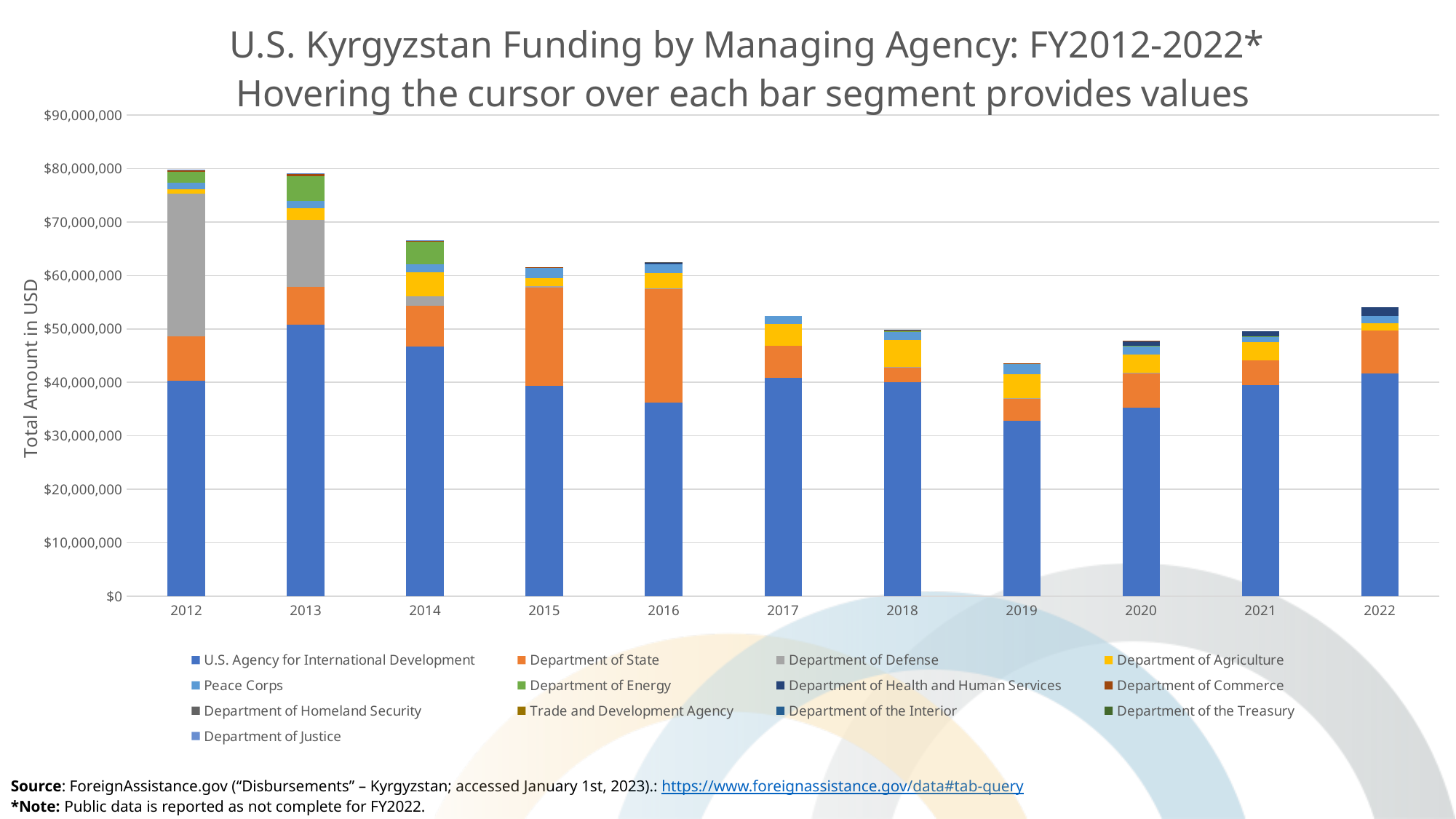
Is the total funding for 2012 greater or less than $70,000,000? greater How many managing agencies does the legend list? 13 What is the label on the y axis? Total Amount in USD Is the total funding for 2019 greater or less than $50,000,000? less Do total funding amounts generally rise or fall from 2012 to 2019? fall How many fiscal years are shown along the x axis? 11 Which year has the larger total funding, 2014 or 2015? 2014 Is the U.S. Agency for International Development value for 2020 greater or less than $40,000,000? less In which year is the U.S. Agency for International Development segment the largest? 2013 What kind of chart is shown on the slide? Stacked bar chart Which year has the lowest total funding? 2019